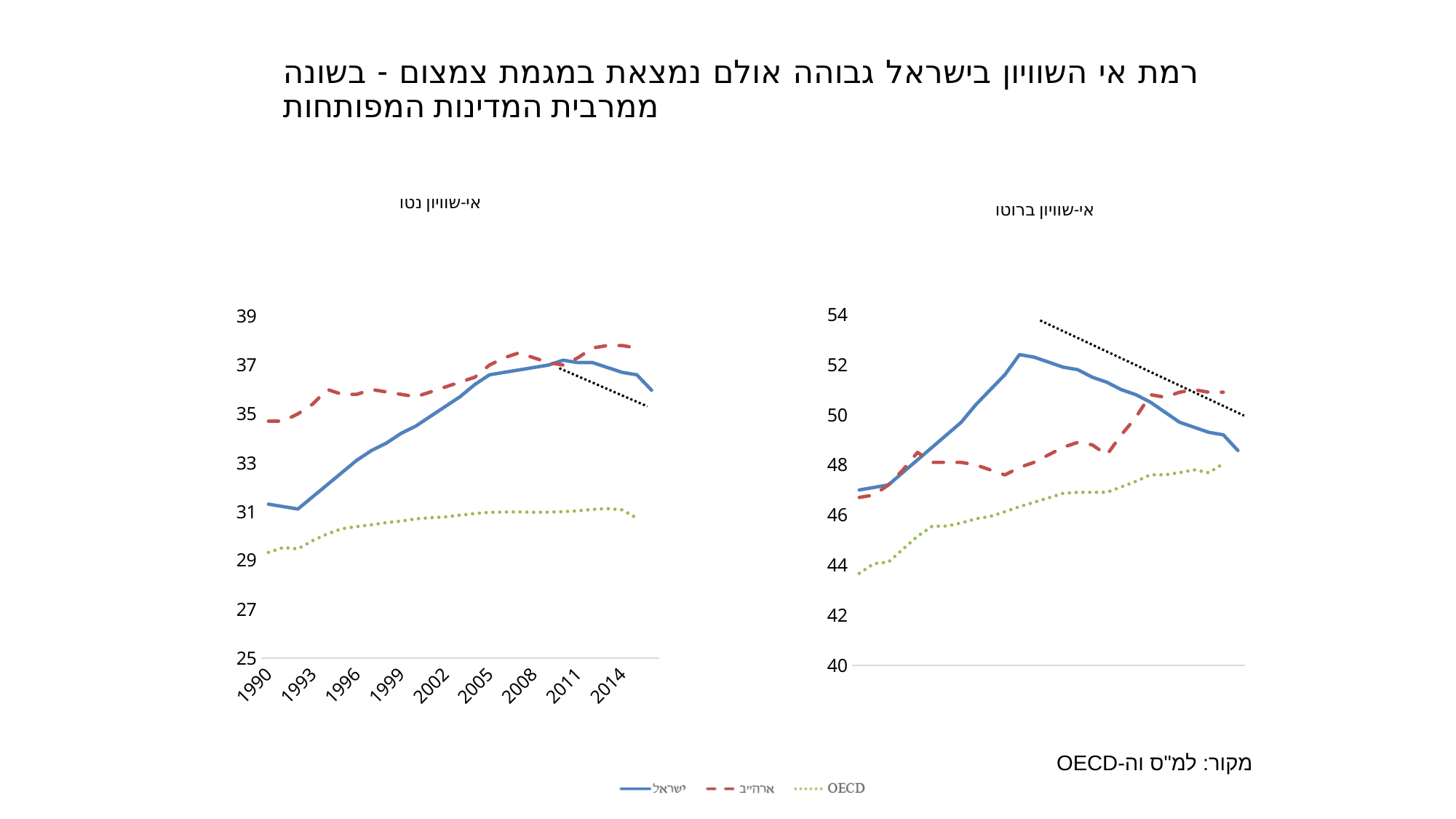
In the left chart (אי-שוויון נטו), is the value for OECD in 1990 greater or less than 31? less What is the title of the right chart? אי-שוויון ברוטו What kind of chart is the left chart titled "אי-שוויון נטו"? line chart In the left chart (אי-שוויון נטו), which series has the higher value in 1990, ישראל or ארה"ב? ארה"ב In the right chart (אי-שוויון ברוטו), which series is higher at the end of the period, ישראל or OECD? ישראל How many series does the legend list? 3 In the left chart (אי-שוויון נטו), is the peak value for ישראל greater or less than 35? greater In the right chart (אי-שוויון ברוטו), is the first value for OECD greater or less than 46? less In the right chart (אי-שוויון ברוטו), does the ישראל series rise or fall after its peak? fall In the left chart (אי-שוויון נטו), does the OECD series generally rise or fall from 1990 to 2014? rise